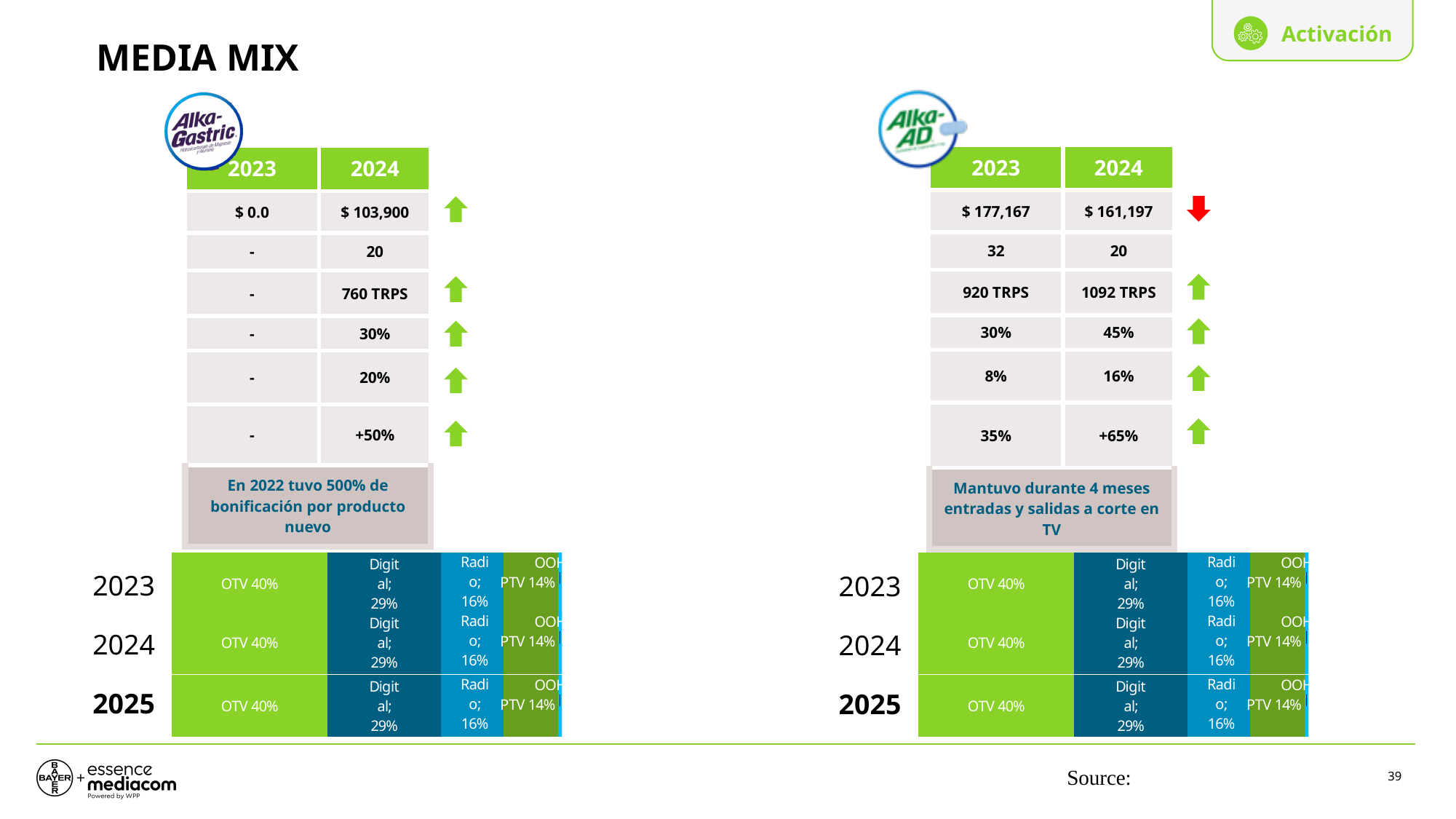
In the Alka-Gastric media mix chart (bottom left), what is the OTV share for 2024? 40% In the Alka-AD media mix chart (bottom right), what is the PTV share for 2024? 14% In the Alka-Gastric media mix chart (bottom left), what is the Digital share for 2025? 29% In the Alka-AD media mix chart (bottom right), what is the OTV share for 2023? 40% What kind of chart is shown at the bottom left of the slide, under the Alka-Gastric table? bar chart In the Alka-AD media mix chart (bottom right), which is larger in 2024: the Digital share or the Radio share? Digital In the Alka-Gastric media mix chart (bottom left), which medium has the largest share in 2023? OTV In the Alka-AD media mix chart (bottom right), what is the Radio share for 2025? 16% How many years (bars) are shown in the Alka-Gastric media mix chart (bottom left)? 3 In the Alka-Gastric media mix chart (bottom left), what is the Radio share for 2023? 16% In the Alka-AD media mix chart (bottom right), does the OTV share rise, fall or stay the same from 2023 to 2025? stays the same In the Alka-Gastric media mix chart (bottom left), what is the difference between the OTV share and the Digital share in 2024? 11%